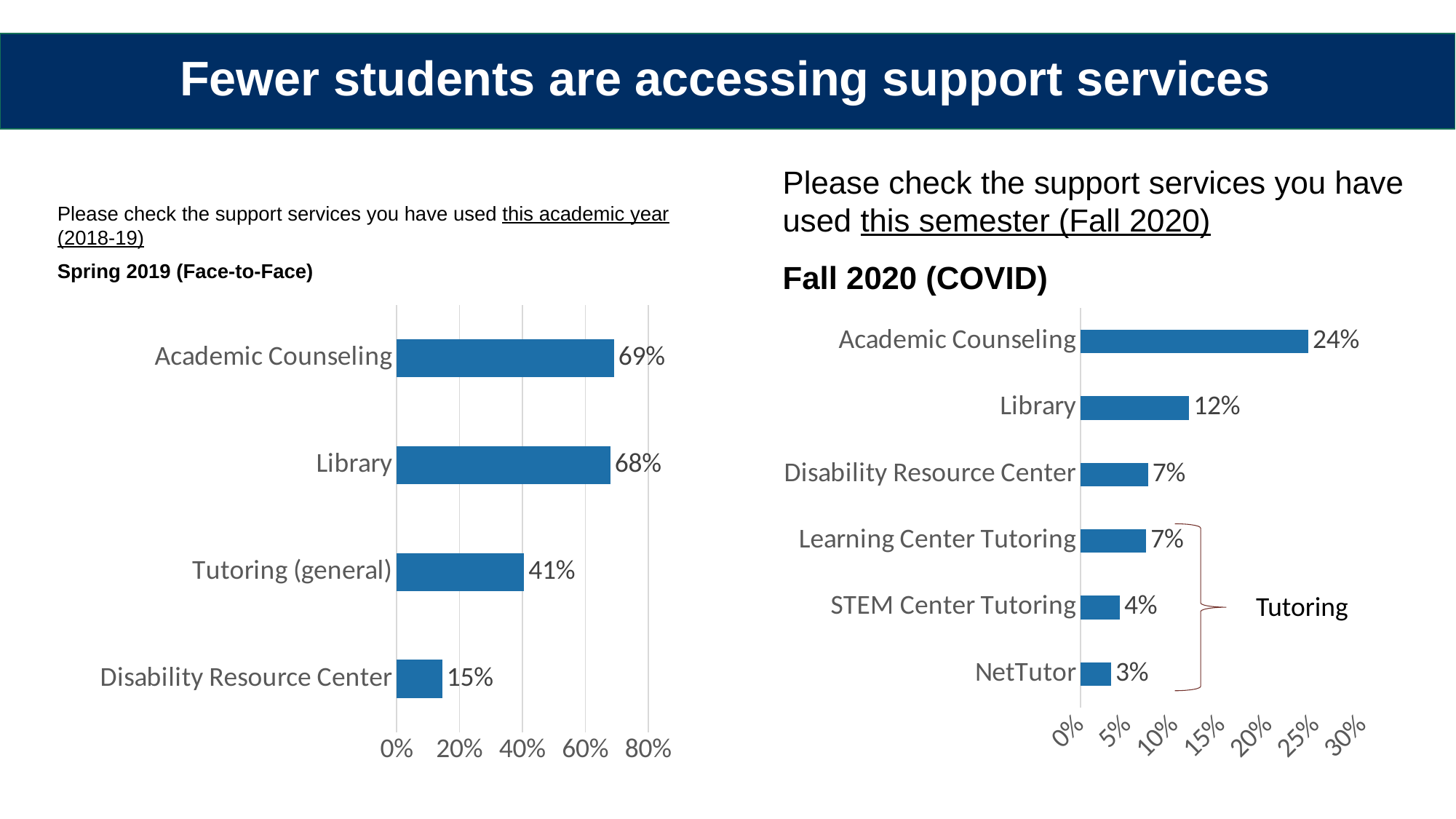
In the Fall 2020 (COVID) chart, what percentage of students used the Library? 12% In the Fall 2020 (COVID) chart, which service has the lowest value? NetTutor In the Spring 2019 (Face-to-Face) chart, which service has the lowest value? Disability Resource Center How many categories are shown in the Fall 2020 (COVID) chart? 6 What type of chart is the Fall 2020 (COVID) chart? Bar chart How many categories are shown in the Spring 2019 (Face-to-Face) chart? 4 In the Spring 2019 (Face-to-Face) chart, what percentage of students used Academic Counseling? 69% In the Fall 2020 (COVID) chart, what is the difference between Academic Counseling and Library? 12% In the Spring 2019 (Face-to-Face) chart, what is the difference between the Tutoring (general) value and the Disability Resource Center value? 26% In the Fall 2020 (COVID) chart, which three categories are grouped by the bracket labelled Tutoring? Learning Center Tutoring, STEM Center Tutoring, NetTutor In the Fall 2020 (COVID) chart, which service has the highest value? Academic Counseling In the Fall 2020 (COVID) chart, which is larger: STEM Center Tutoring or NetTutor? STEM Center Tutoring